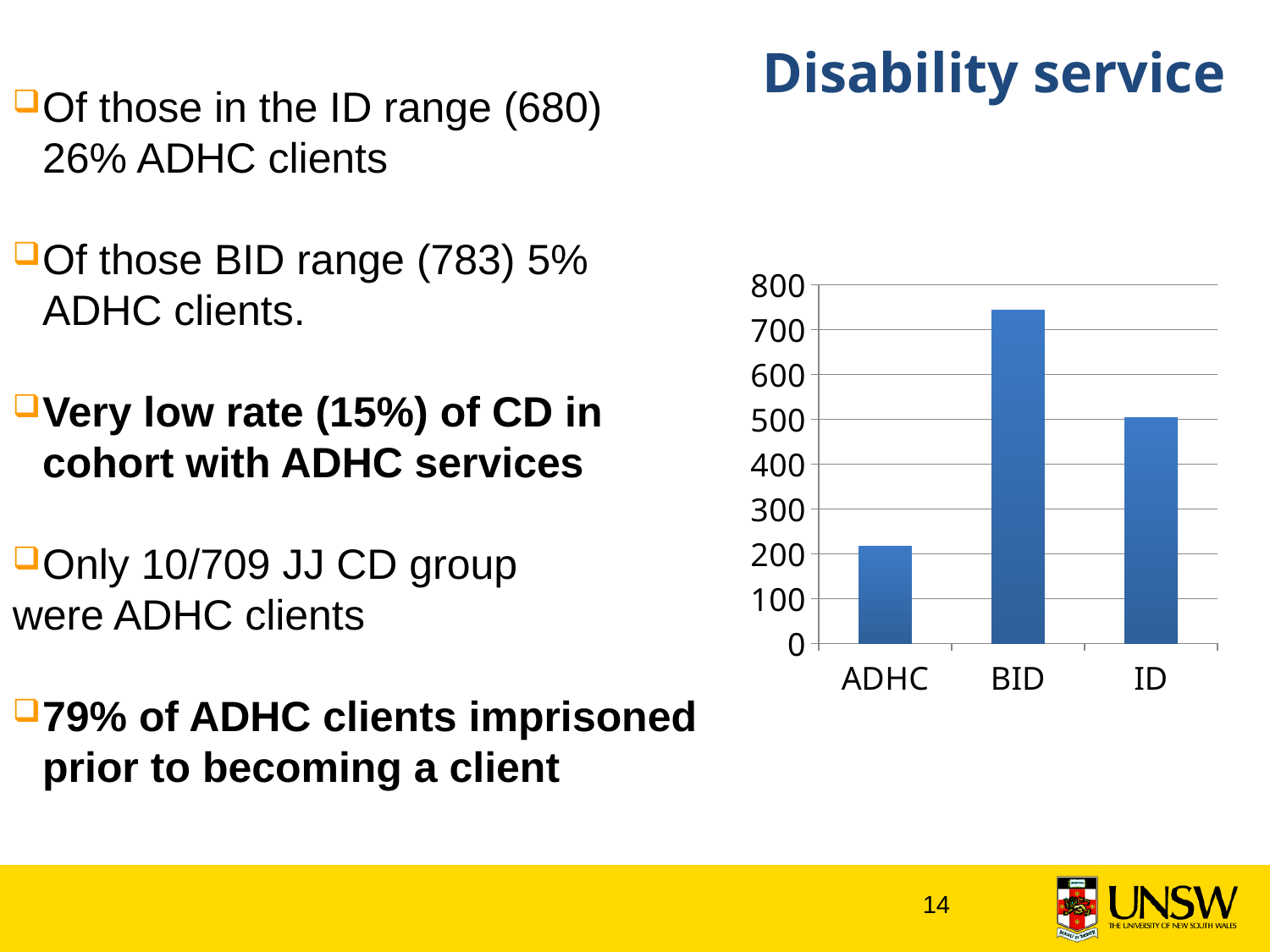
Which is larger, the value for BID or the value for ID? BID What is the highest value shown on the chart's vertical axis? 800 Is the value for ADHC greater or less than 300? less How many categories are shown on the x axis of the chart? 3 Is the value for BID greater or less than 800? less Is the value for ADHC greater or less than 200? greater Which category has the lowest bar in the chart? ADHC What kind of chart is shown on the slide? bar chart Which is larger, the value for ADHC or the value for ID? ID Which category has the highest bar in the chart? BID